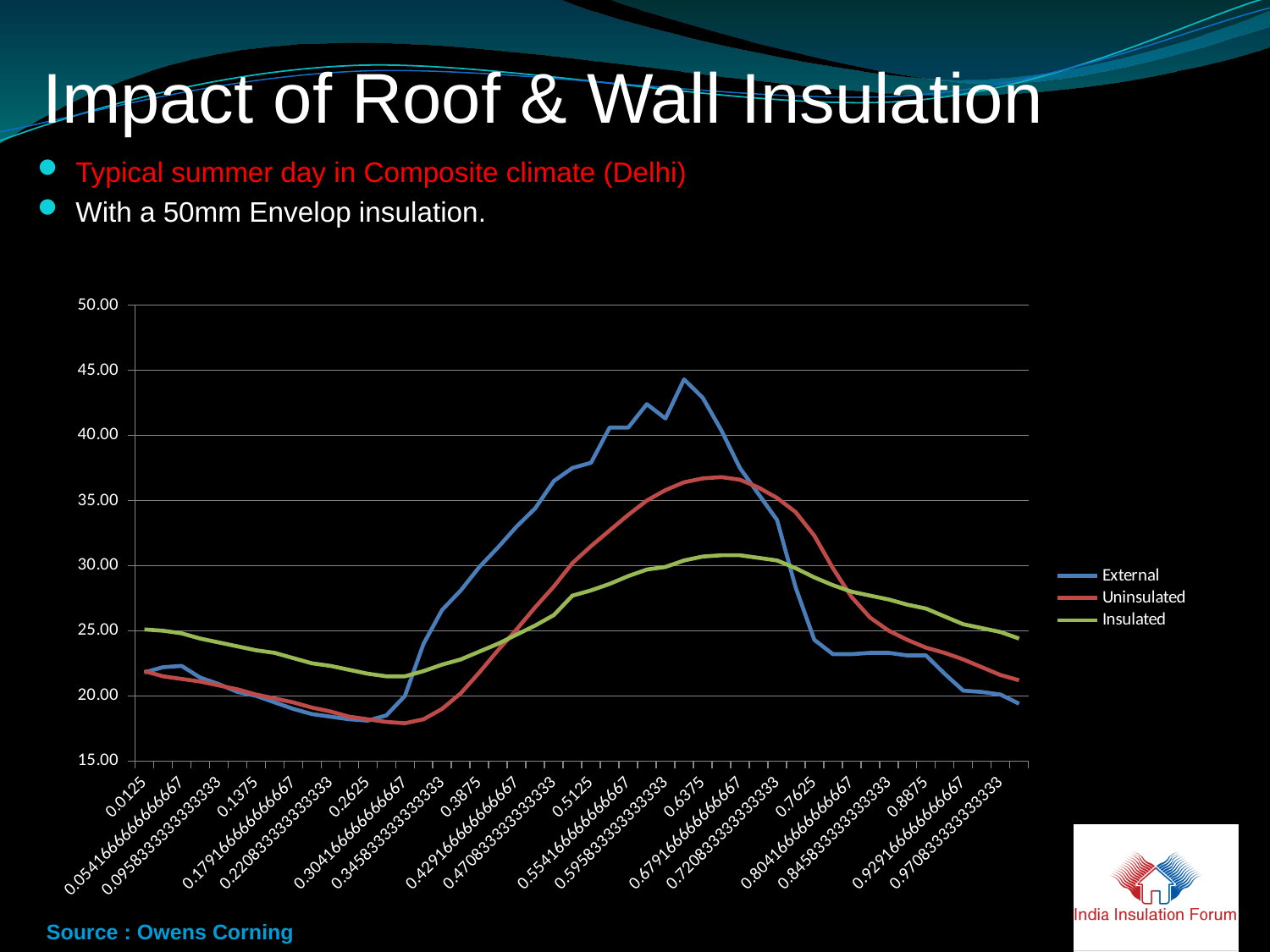
Is the peak value of the Uninsulated series greater or less than 35.00? greater What kind of chart is shown on the slide? line chart How many series does the legend list? 3 Which series has the lowest peak value? Insulated Is the lowest value of the Uninsulated series greater or less than 20.00? less Which colour is used for the Insulated series? green At 0.6375, which is higher, the External series or the Insulated series? External Is the peak value of the External series greater or less than 40.00? greater Which series reaches the highest peak value? External Does the External series rise or fall between 0.3875 and 0.6375? rise What are the three series named in the legend? External, Uninsulated, Insulated